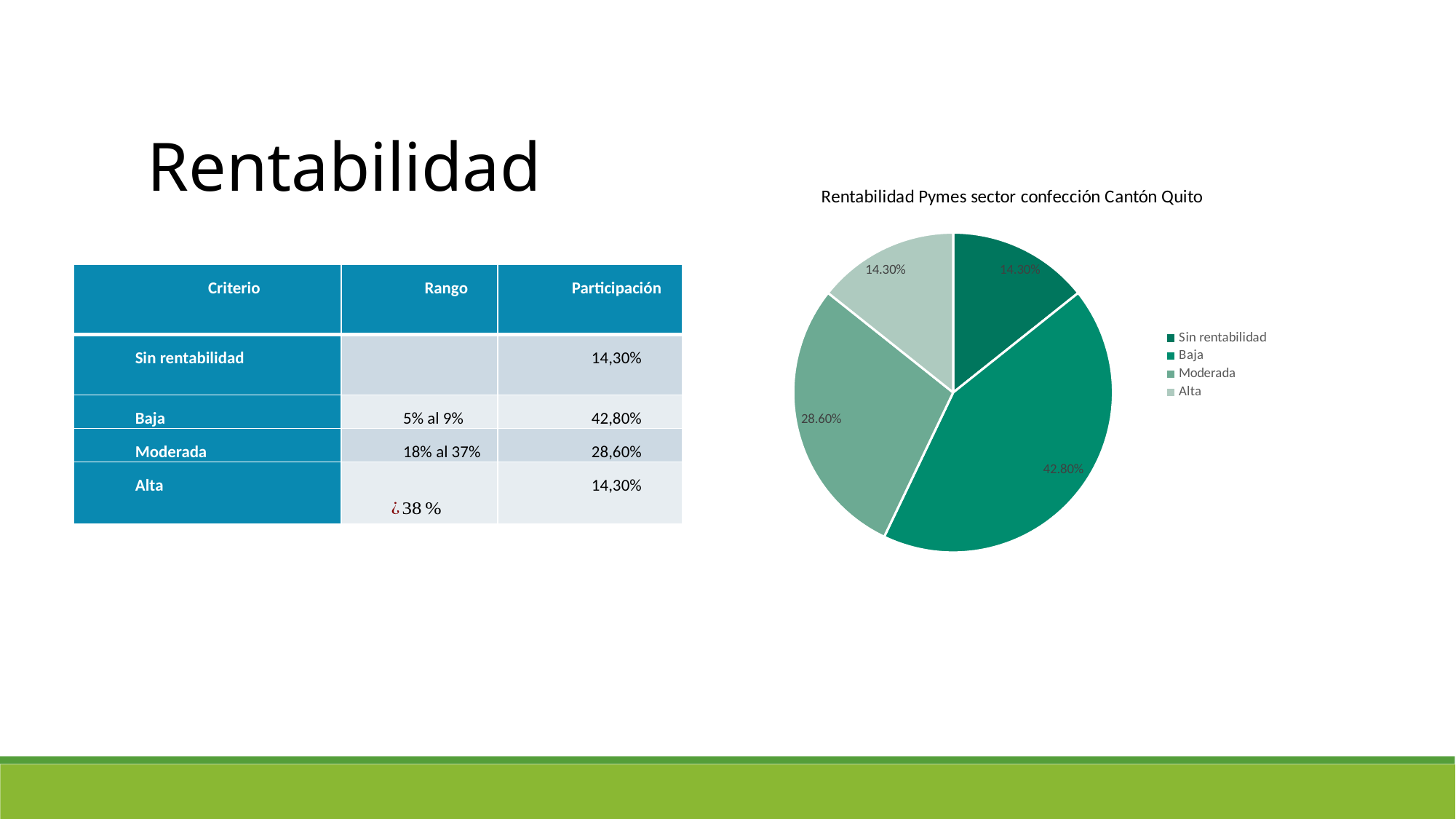
What is the value shown for Moderada in the pie chart? 28.60% What is the value shown for Alta in the pie chart? 14.30% What is the difference between the Baja and Moderada values in the pie chart? 14.20% How many slices does the pie chart have? 4 Which is larger in the pie chart, Baja or Moderada? Baja What is the difference between the Moderada and Alta values in the pie chart? 14.30% What is the title of the chart? Rentabilidad Pymes sector confección Cantón Quito What type of chart is shown on the slide? pie chart Which legend entry is listed first in the pie chart legend? Sin rentabilidad What is the value shown for Baja in the pie chart? 42.80% How many entries does the chart legend list? 4 Which category has the largest slice in the pie chart? Baja